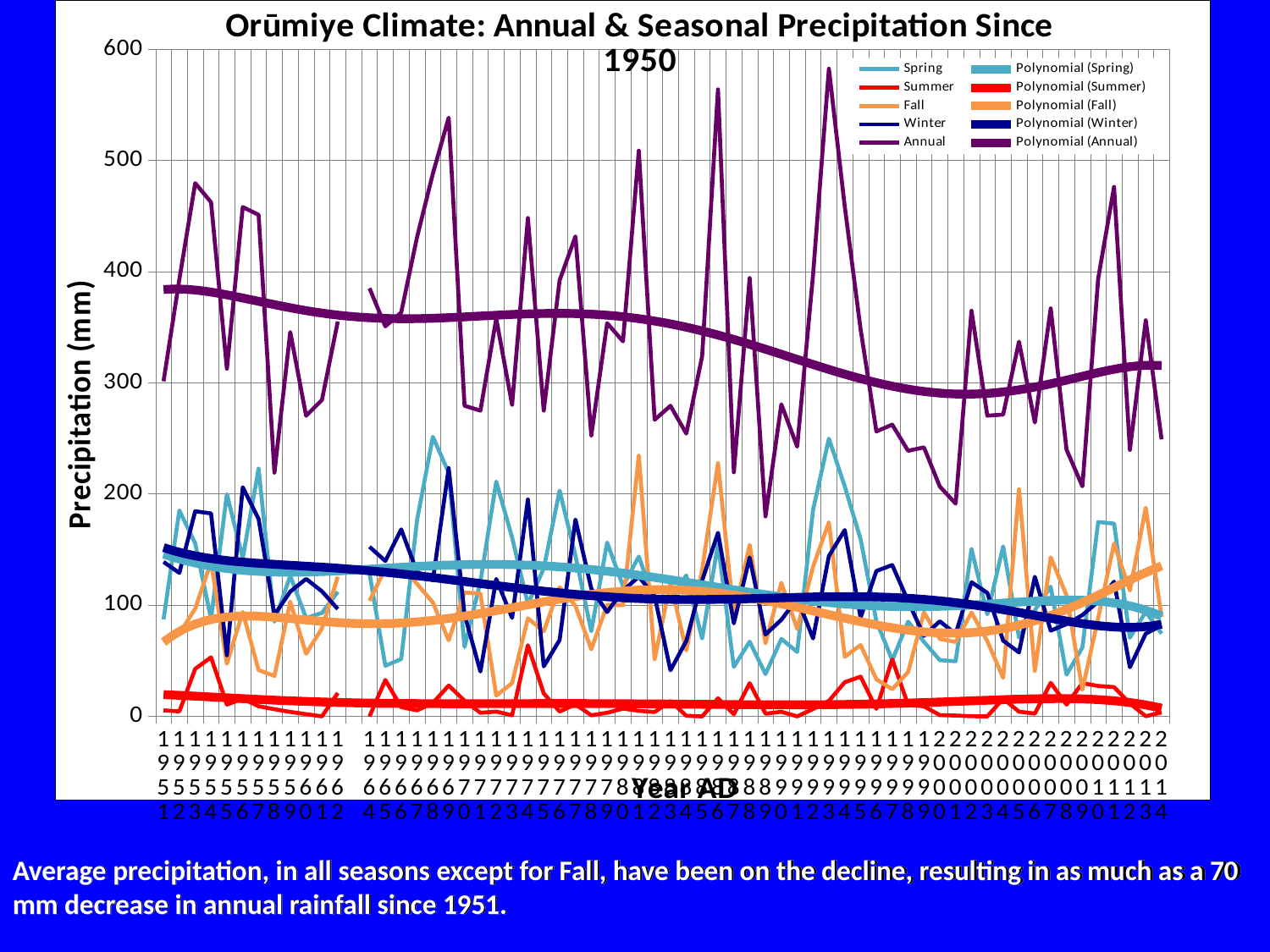
Which series has the highest values on the chart? Annual Does the Polynomial (Annual) trend line rise or fall overall from left to right? fall Does the Polynomial (Winter) trend line rise or fall overall from left to right? fall Is the highest value of the Summer series greater or less than 100? less Which series has the lowest values on the chart? Summer How many series does the legend list? 10 Is the highest value of the Annual series greater or less than 500? greater Which series is higher throughout the chart, Annual or Summer? Annual What is the label of the vertical axis? Precipitation (mm) What kind of chart is shown on the slide? Line chart Does the Polynomial (Fall) trend line rise or fall overall from left to right? rise What is the title of the chart? Orūmiye Climate: Annual & Seasonal Precipitation Since 1950